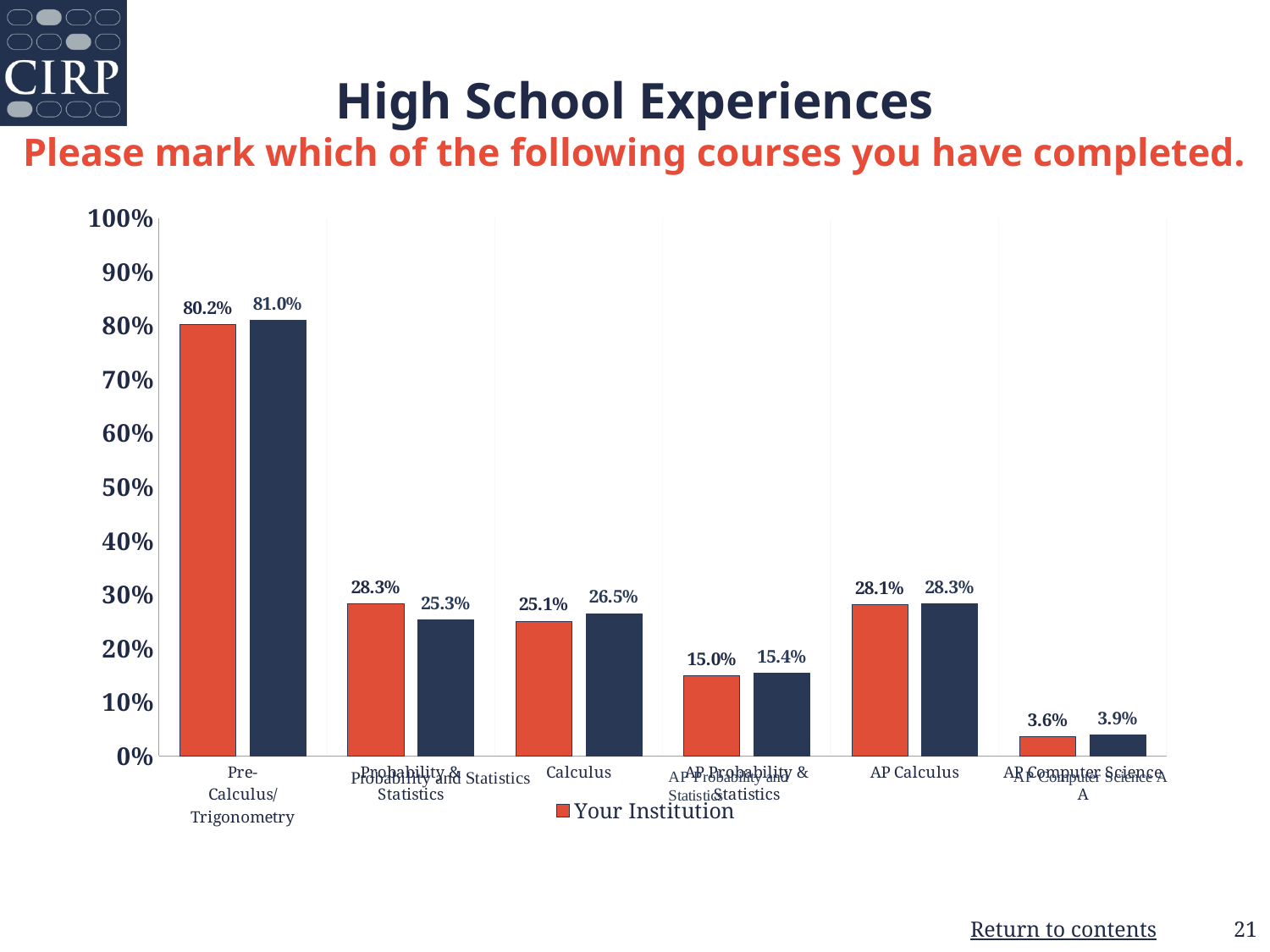
Which course has the highest Your Institution value? Pre-Calculus/Trigonometry For AP Probability & Statistics, which is larger: the Your Institution bar or the dark blue bar? the dark blue bar What is the value of the dark blue bar for AP Computer Science A? 3.9% What is the title of the chart on the slide? High School Experiences What is the Your Institution value for AP Calculus? 28.1% Which course has the lowest Your Institution value? AP Computer Science A Is the Your Institution value for Calculus greater or less than 30%? less What is the difference between the Your Institution value and the dark blue bar value for Probability & Statistics? 3.0% What is the value of the dark blue bar for Calculus? 26.5% What is the Your Institution value for Pre-Calculus/Trigonometry? 80.2% How many course categories are shown on the x axis? 6 What type of chart is shown on the slide? bar chart